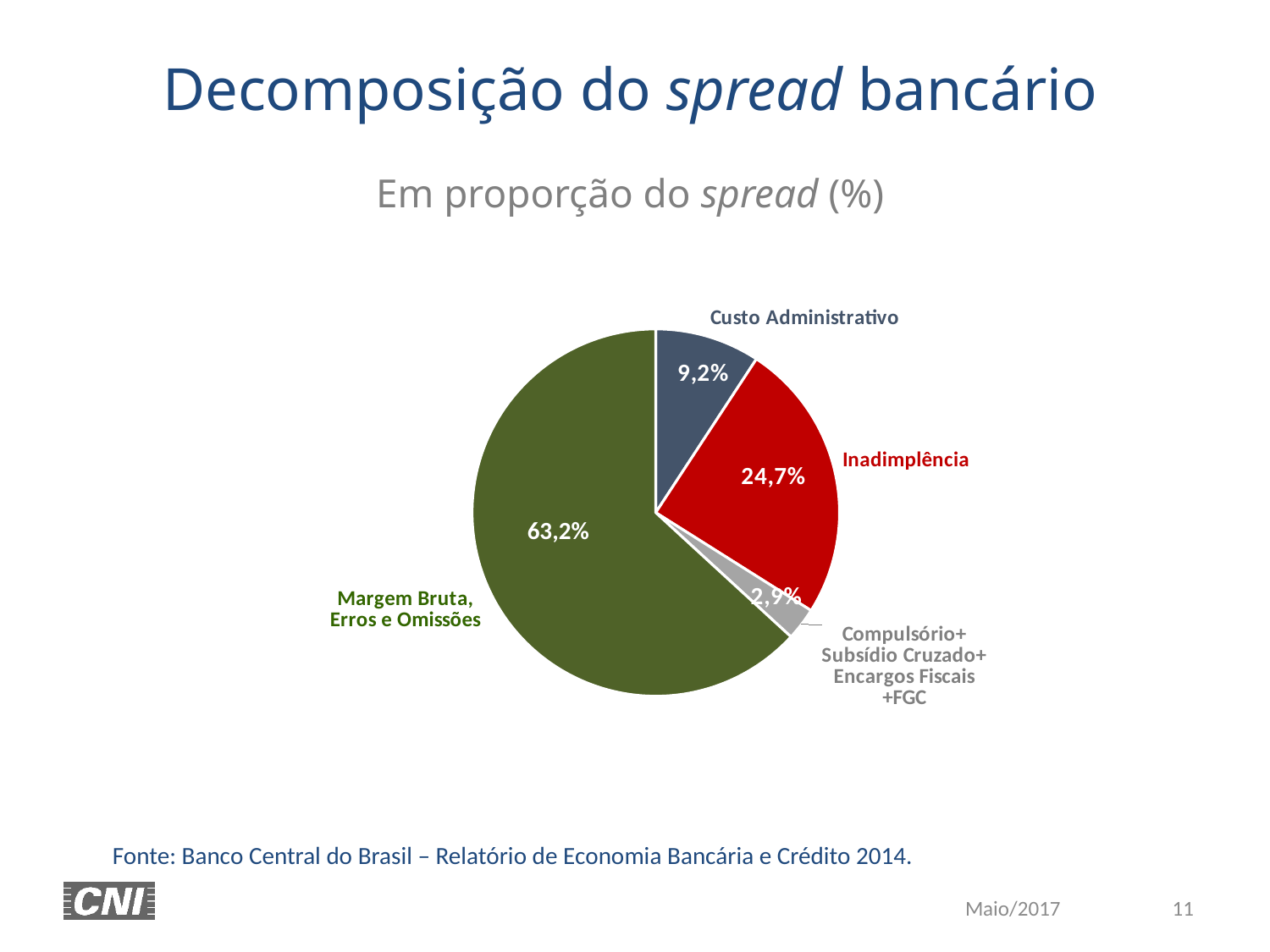
What share of the spread does Margem Bruta, Erros e Omissões represent? 63,2% What share of the spread does Inadimplência represent? 24,7% What is the difference in percentage points between Margem Bruta, Erros e Omissões and Inadimplência? 38,5 Which component has the largest share of the spread? Margem Bruta, Erros e Omissões Which is larger, the share for Inadimplência or the share for Custo Administrativo? Inadimplência Which component has the smallest share of the spread? Compulsório+Subsídio Cruzado+Encargos Fiscais+FGC What is the difference in percentage points between Inadimplência and Custo Administrativo? 15,5 What share of the spread does Compulsório+Subsídio Cruzado+Encargos Fiscais+FGC represent? 2,9% What share of the spread does Custo Administrativo represent? 9,2% How many slices does the pie chart have? 4 What kind of chart is shown on the slide? Pie chart What colour is the Inadimplência slice? Red